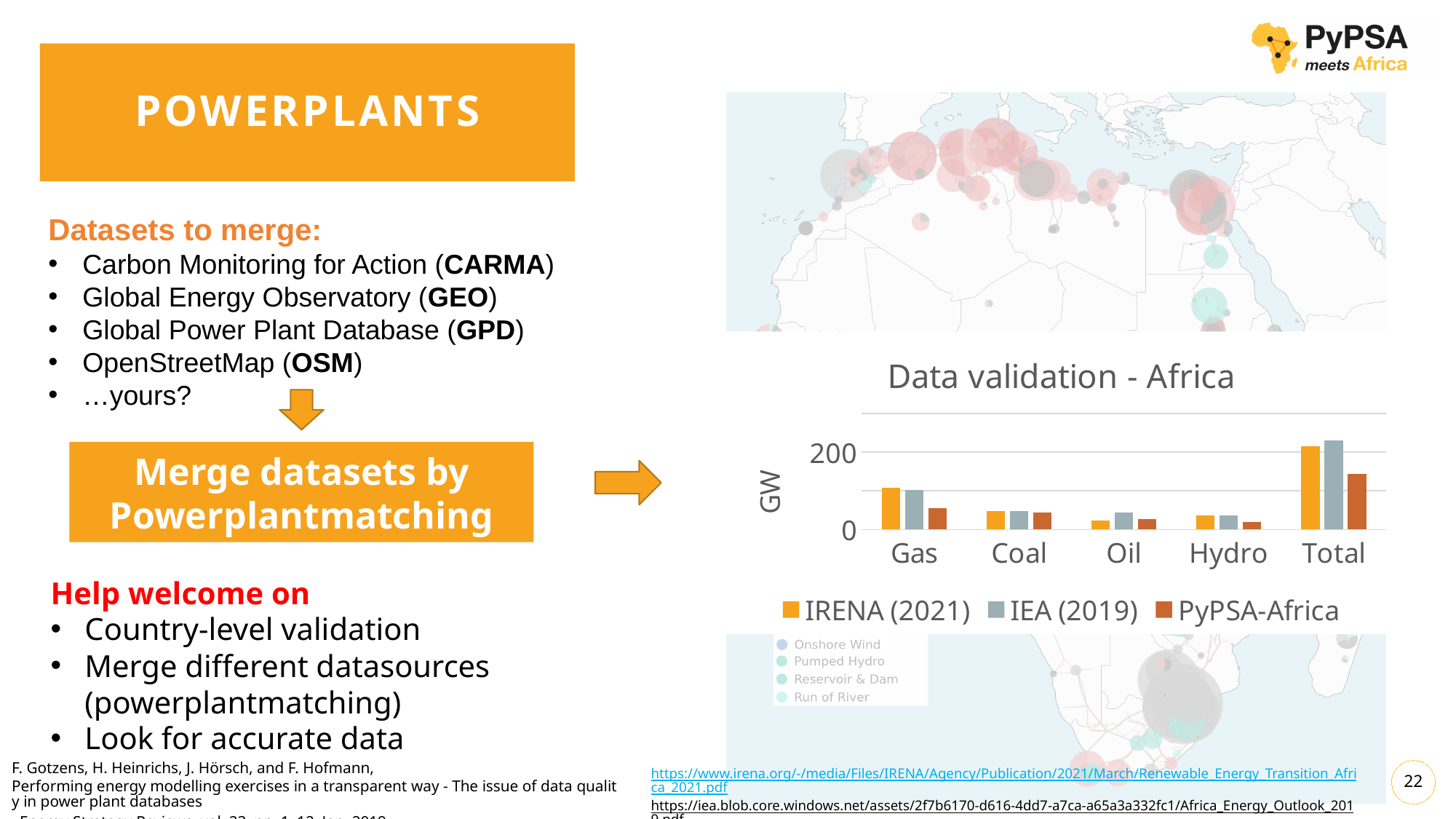
In the "Data validation - Africa" chart, how many categories are shown on the x axis? 5 What is the title of the bar chart on the slide? Data validation - Africa In the "Data validation - Africa" chart, is the IEA (2019) value for Total greater or less than 200? greater What is the y-axis label of the "Data validation - Africa" chart? GW In the "Data validation - Africa" chart, which is larger for Total: the IEA (2019) value or the PyPSA-Africa value? IEA (2019) How many series does the legend of the "Data validation - Africa" chart list? 3 What type of chart is shown under the title "Data validation - Africa"? bar chart In the "Data validation - Africa" chart, which category has the lowest IRENA (2021) value? Oil In the "Data validation - Africa" chart, which category has the highest IRENA (2021) value? Total In the "Data validation - Africa" chart, is the IRENA (2021) value for Gas greater or less than 200? less In the "Data validation - Africa" chart, is the PyPSA-Africa value for Total greater or less than 200? less In the "Data validation - Africa" chart, which is larger for Gas: the IRENA (2021) value or the PyPSA-Africa value? IRENA (2021)